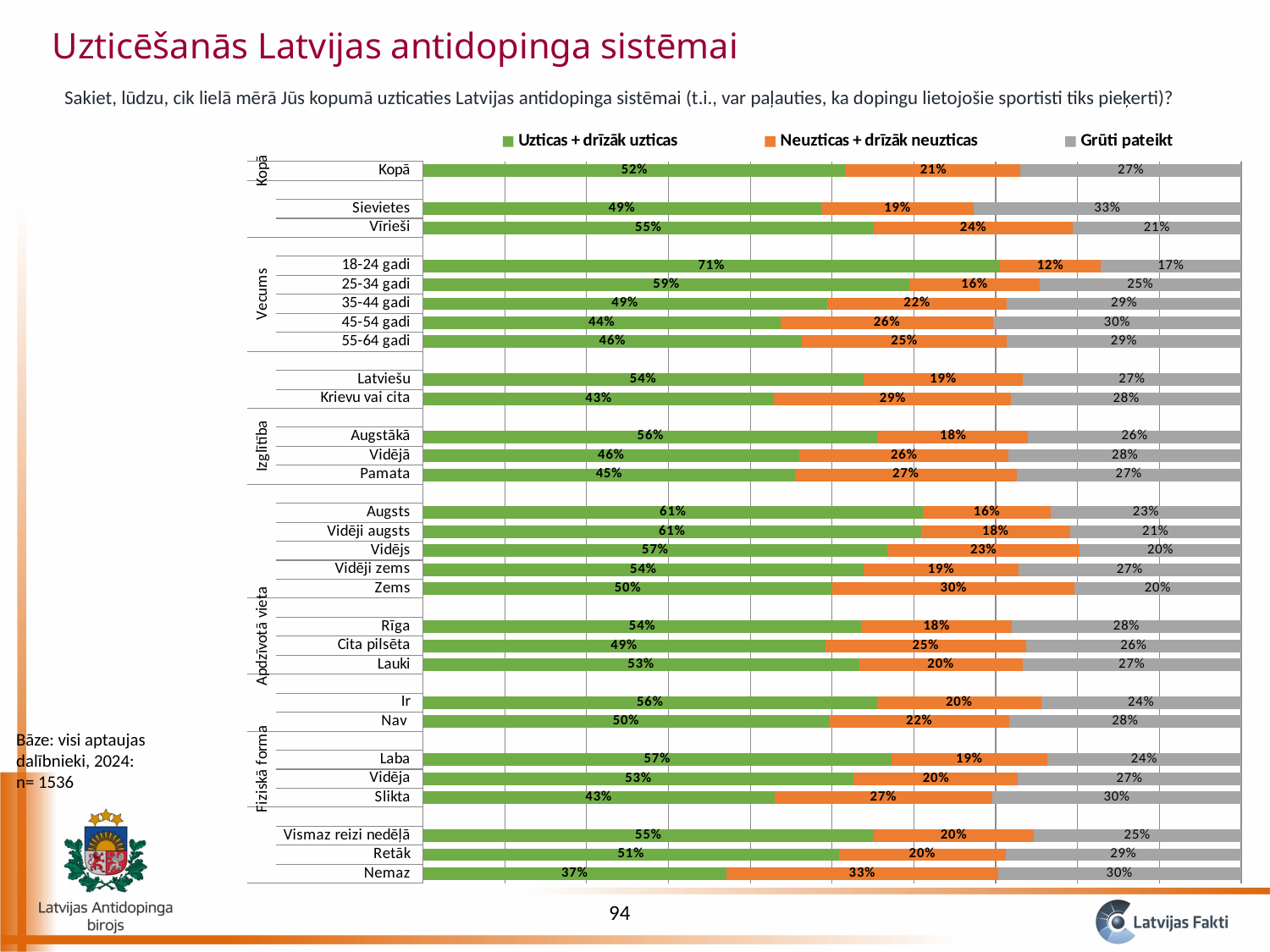
Which category has the lowest "Uzticas + drīzāk uzticas" value? Nemaz What kind of chart is shown on the slide? Stacked bar chart What is the "Grūti pateikt" value for "Sievietes"? 33% Which category has the lowest "Neuzticas + drīzāk neuzticas" value? 18-24 gadi What is the "Uzticas + drīzāk uzticas" value for "18-24 gadi"? 71% Which colour represents "Grūti pateikt" in the chart? Grey How many series does the legend list? 3 What is the total of the three values for "Kopā"? 100% What is the "Neuzticas + drīzāk neuzticas" value for "Nemaz"? 33% Which has a larger "Neuzticas + drīzāk neuzticas" value, "Latviešu" or "Krievu vai cita"? Krievu vai cita Which category has the highest "Uzticas + drīzāk uzticas" value? 18-24 gadi What is the difference between the "Uzticas + drīzāk uzticas" values for "Vīrieši" and "Sievietes"? 6%